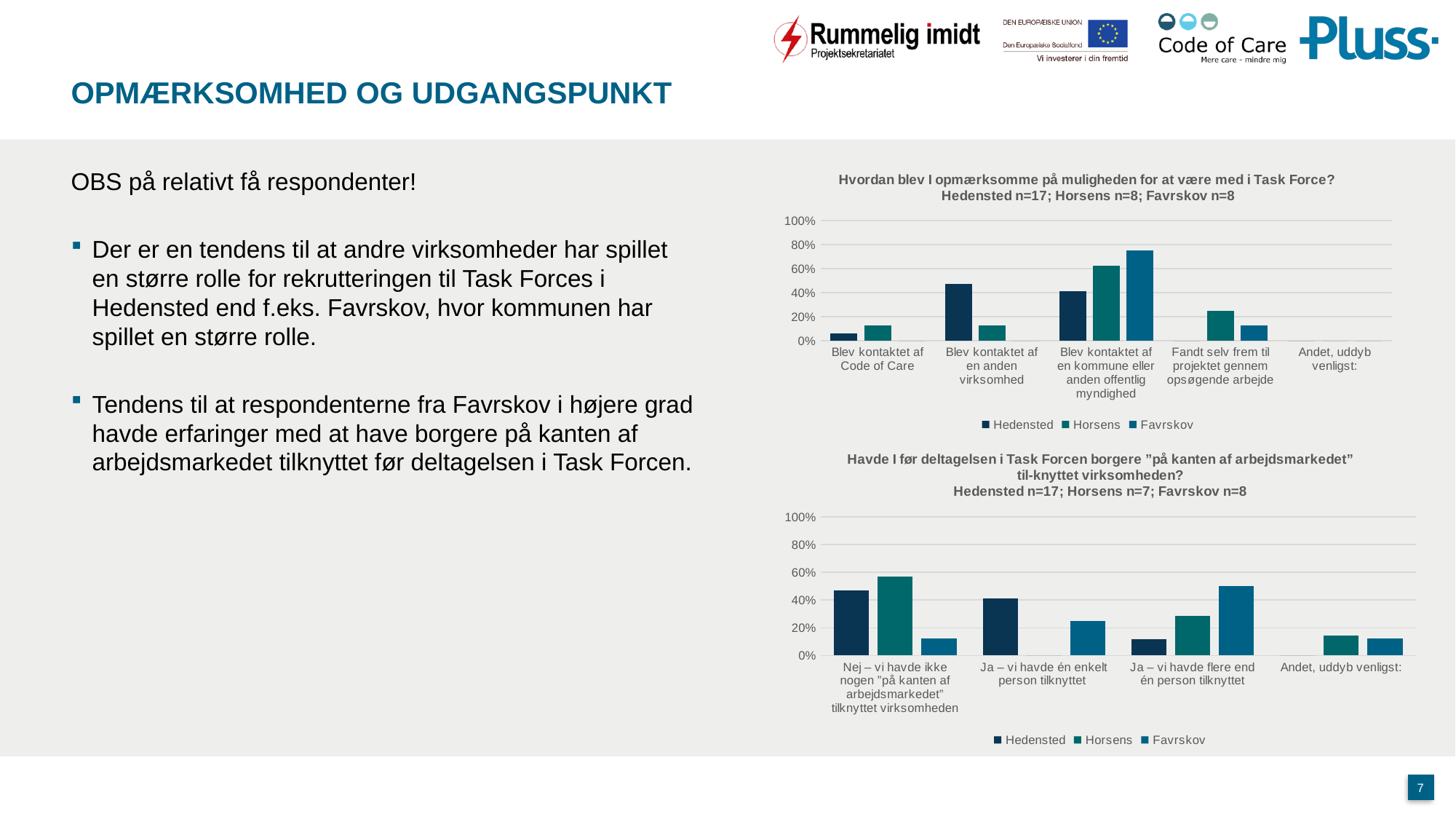
In the bottom chart (Havde I før deltagelsen...), how many categories are shown on the x axis? 4 In the bottom chart (Havde I før deltagelsen...), which series has the highest bar for 'Ja – vi havde flere end én person tilknyttet'? Favrskov In the bottom chart (Havde I før deltagelsen...), is the Horsens value for 'Nej – vi havde ikke nogen "på kanten af arbejdsmarkedet" tilknyttet virksomheden' greater or less than 40%? greater In the top chart (Hvordan blev I opmærksomme...), how many series does the legend list? 3 In the bottom chart (Havde I før deltagelsen...), which series is listed first in the legend? Hedensted What kind of chart is the bottom chart (Havde I før deltagelsen i Task Forcen borgere 'på kanten af arbejdsmarkedet' tilknyttet virksomheden?)? Bar chart In the top chart (Hvordan blev I opmærksomme på muligheden for at være med i Task Force?), how many categories are shown on the x axis? 5 In the top chart (Hvordan blev I opmærksomme...), which is larger for 'Blev kontaktet af en anden virksomhed': Hedensted or Horsens? Hedensted In the top chart (Hvordan blev I opmærksomme...), which series has the highest bar for 'Blev kontaktet af en kommune eller anden offentlig myndighed'? Favrskov In the top chart (Hvordan blev I opmærksomme...), is the Hedensted value for 'Blev kontaktet af en anden virksomhed' greater or less than 20%? greater In the top chart (Hvordan blev I opmærksomme...), is the Favrskov value for 'Blev kontaktet af en kommune eller anden offentlig myndighed' greater or less than 60%? greater In the bottom chart (Havde I før deltagelsen...), which is larger for 'Ja – vi havde én enkelt person tilknyttet': Hedensted or Favrskov? Hedensted